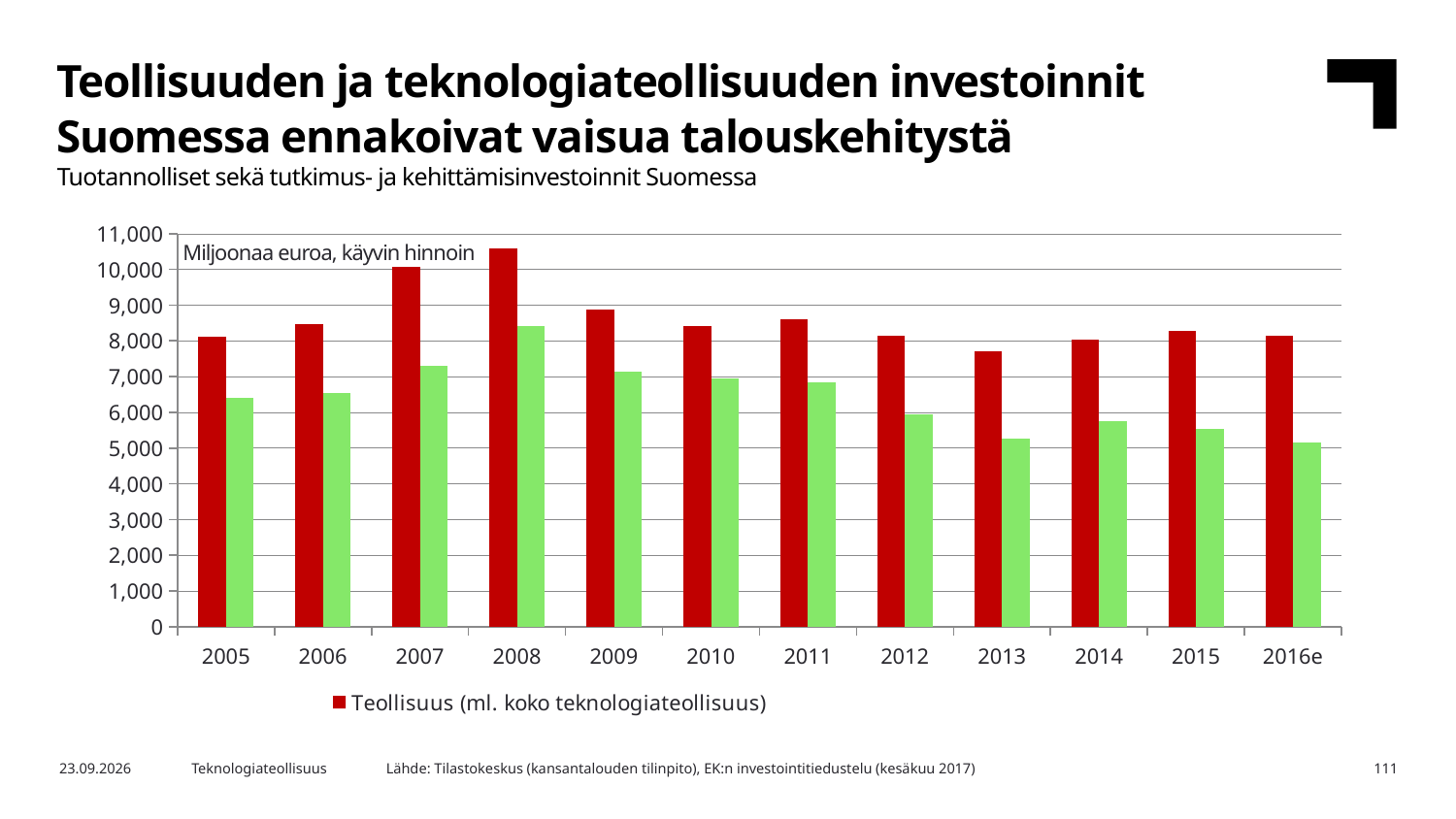
Is the red Teollisuus value for 2008 greater or less than 10,000? greater Do the green bars rise or fall from 2008 to 2013? Fall What kind of chart is shown on the slide? Bar chart In which year is the green bar the highest? 2008 Is the red Teollisuus value for 2013 greater or less than 8,000? less What unit label is printed inside the chart area? Miljoonaa euroa, käyvin hinnoin Is the green bar value for 2011 greater or less than 7,000? less In which year is the red Teollisuus bar the highest? 2008 How many entries does the chart's legend list? 1 In which year is the red Teollisuus bar the lowest? 2013 Which is larger, the red Teollisuus bar for 2008 or for 2009? 2008 How many years are shown on the x axis of the chart? 12